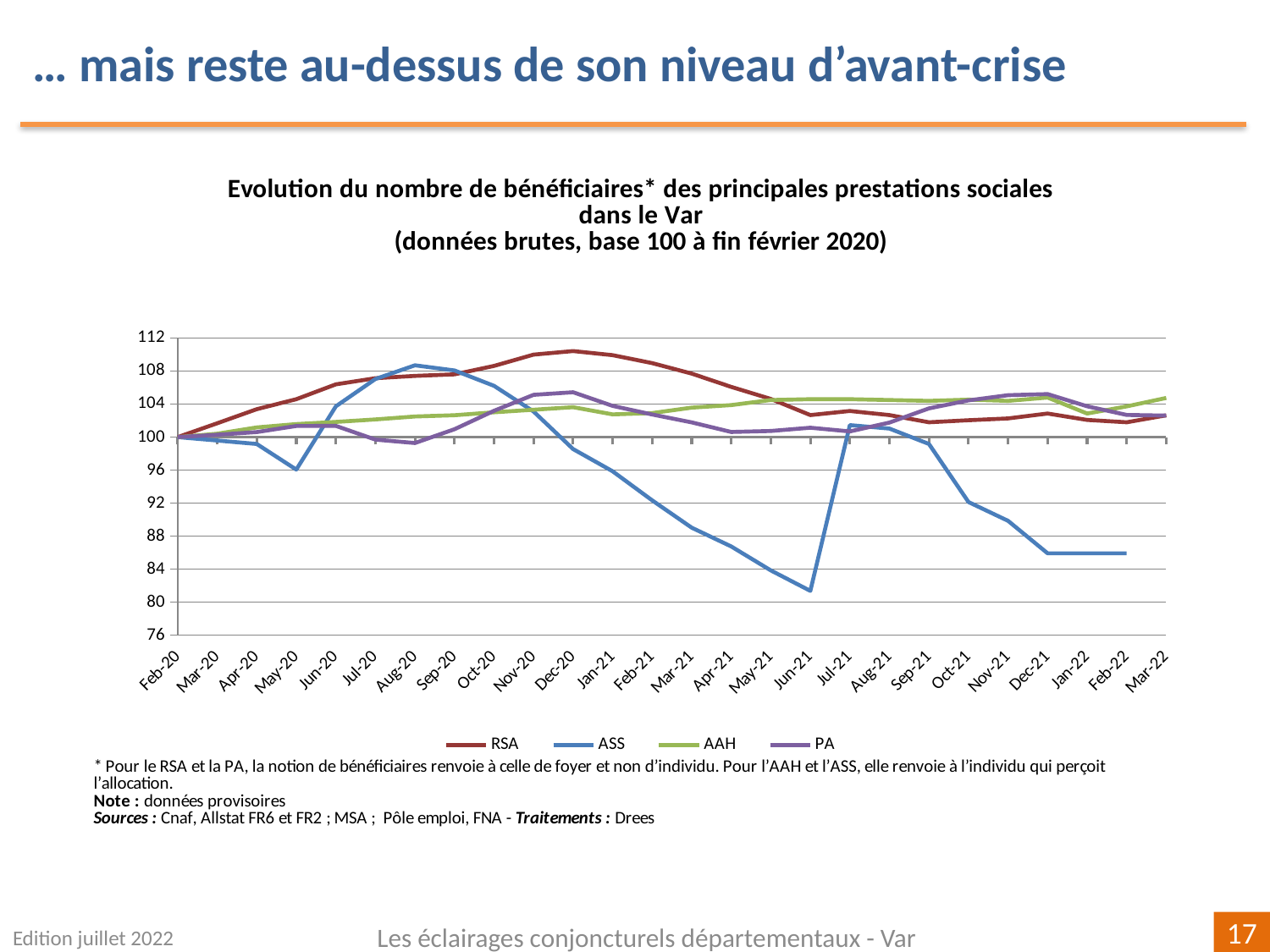
Which series has the highest value at Dec-20? RSA Does the ASS series rise or fall between Jul-21 and Feb-22? fall How many series does the legend list? 4 Is the value for ASS at Feb-22 greater or less than 88? less At Jun-21, which is larger, the value for RSA or the value for ASS? RSA Is the value for RSA at Dec-20 greater or less than 108? greater Is the value for ASS at Jun-21 greater or less than 84? less Which series are listed in the legend? RSA, ASS, AAH, PA What kind of chart is shown on the slide? line chart Which series has the lowest value at Jun-21? ASS What is the value of each series at Feb-20, the base month? 100 How many monthly points are plotted along the x axis, from Feb-20 to Mar-22? 26